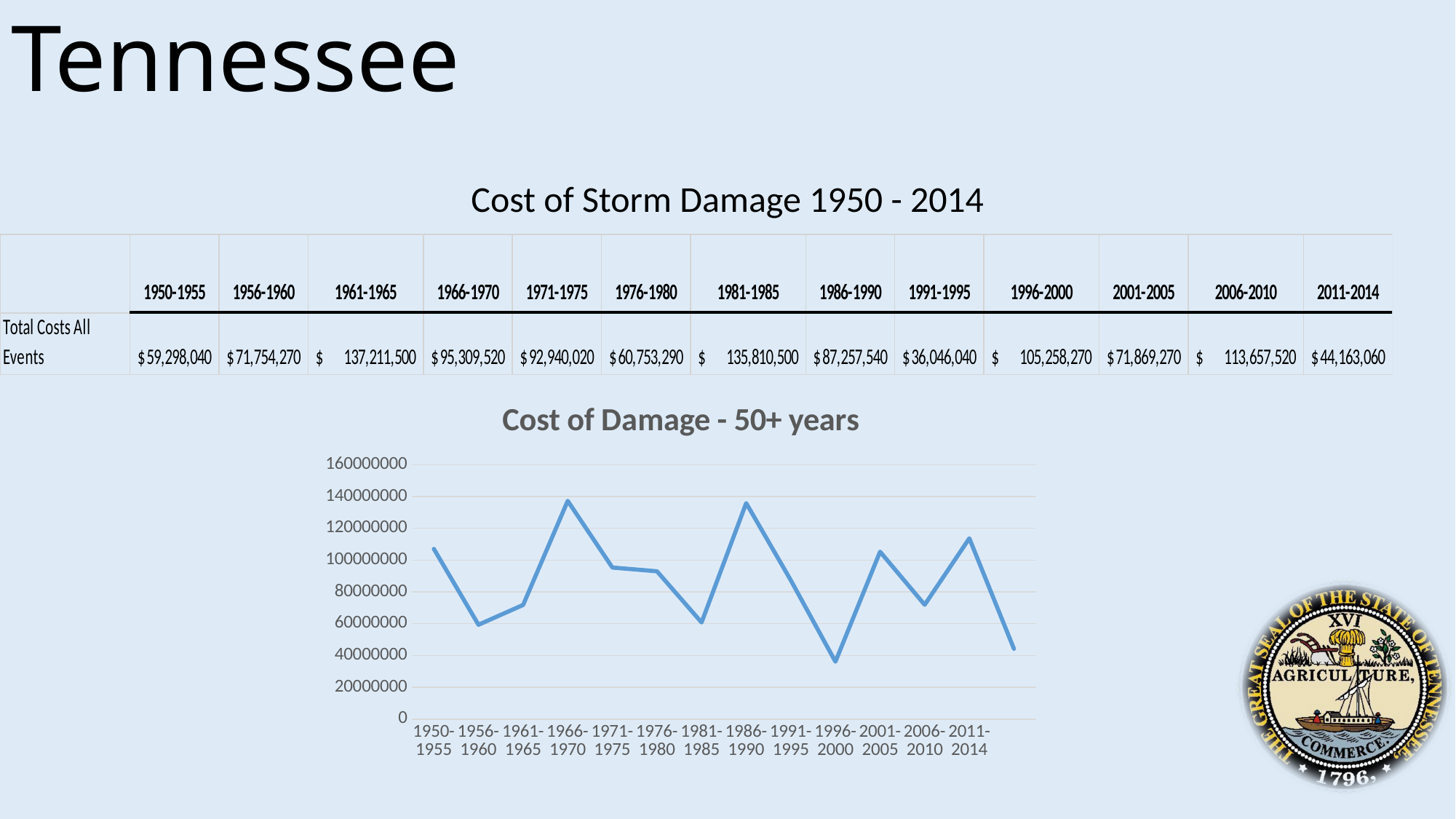
What is the highest value shown on the y axis of the "Cost of Damage - 50+ years" chart? 160000000 According to the table, which period has the lowest total cost of all events? 1991-1995 According to the table, which is larger: the total cost for 1981-1985 or for 1986-1990? 1981-1985 According to the table, what is the total cost of all events for 1961-1965? $137,211,500 In the "Cost of Damage - 50+ years" chart, is the last point on the line higher or lower than the first point? lower In the "Cost of Damage - 50+ years" chart, is the value plotted above the 1971-1975 label greater or less than 80000000? greater What is the title of the chart on the slide? Cost of Damage - 50+ years According to the table, which period has the highest total cost of all events? 1961-1965 In the "Cost of Damage - 50+ years" chart, is the highest point on the line greater or less than 140000000? less According to the table, what is the total cost of all events for 2011-2014? $44,163,060 What kind of chart is "Cost of Damage - 50+ years"? line chart In the "Cost of Damage - 50+ years" chart, is the lowest point on the line greater or less than 40000000? less